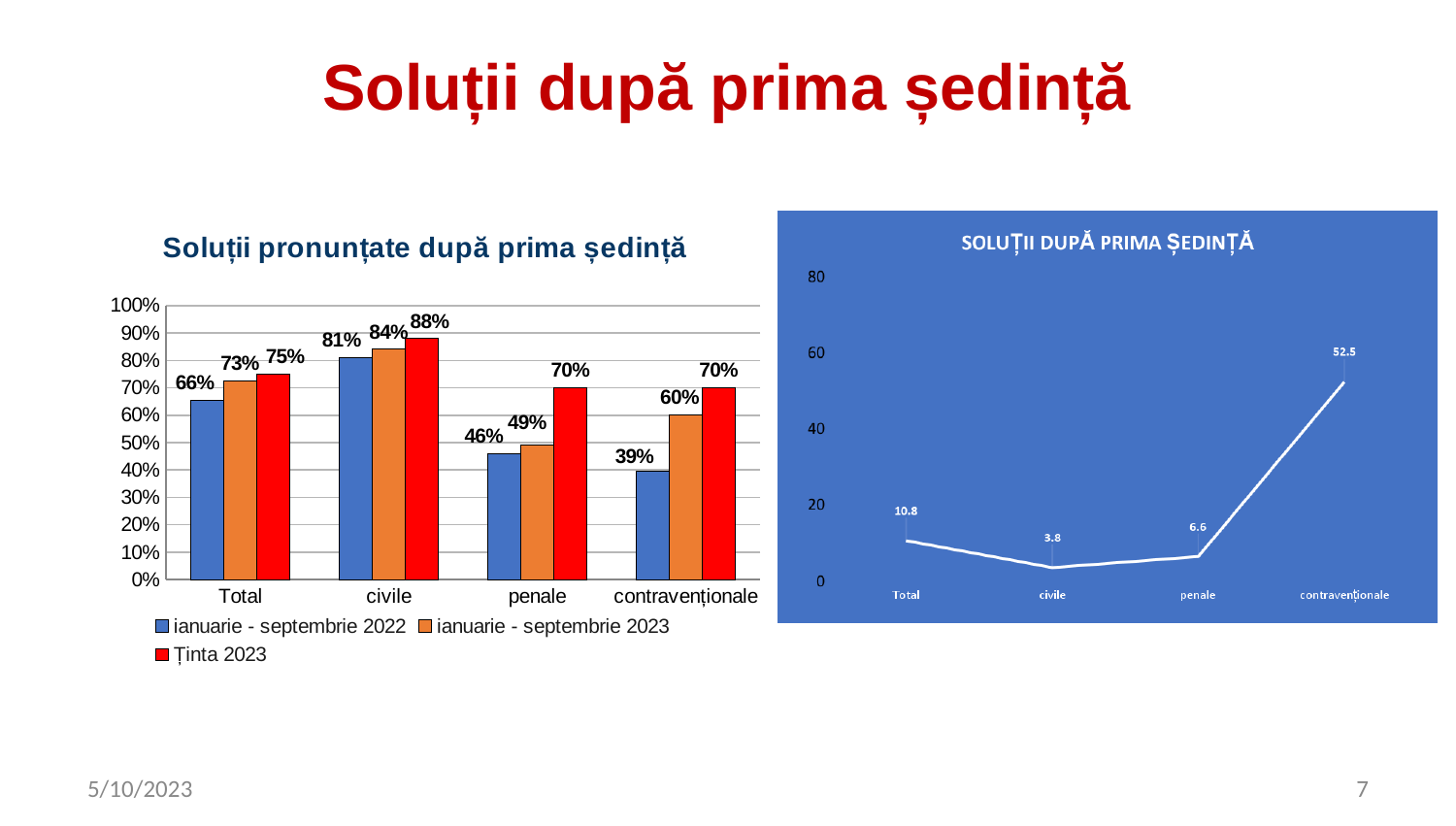
In the left chart 'Soluții pronunțate după prima ședință', which category has the highest value in the 'ianuarie - septembrie 2022' series? civile What kind of chart is the right chart 'SOLUȚII DUPĂ PRIMA ȘEDINȚĂ'? line chart In the right chart 'SOLUȚII DUPĂ PRIMA ȘEDINȚĂ', what is the difference between the values for 'Total' and 'penale'? 4.2 In the left chart 'Soluții pronunțate după prima ședință', what is the difference between the 'Ținta 2023' value and the 'ianuarie - septembrie 2023' value for 'contravenționale'? 10% In the left chart 'Soluții pronunțate după prima ședință', what is the value for 'civile' in the 'ianuarie - septembrie 2023' series? 84% In the left chart 'Soluții pronunțate după prima ședință', how many series does the legend list? 3 In the left chart 'Soluții pronunțate după prima ședință', what is the 'Ținta 2023' value for 'penale'? 70% In the right chart 'SOLUȚII DUPĂ PRIMA ȘEDINȚĂ', which category has the lowest value? civile In the left chart 'Soluții pronunțate după prima ședință', which category has the lowest value in the 'ianuarie - septembrie 2023' series? penale In the left chart 'Soluții pronunțate după prima ședință', which is larger for 'Total': the 'ianuarie - septembrie 2022' value or the 'ianuarie - septembrie 2023' value? ianuarie - septembrie 2023 In the right chart 'SOLUȚII DUPĂ PRIMA ȘEDINȚĂ', what is the value for 'contravenționale'? 52.5 In the left chart 'Soluții pronunțate după prima ședință', what is the value for 'contravenționale' in the 'ianuarie - septembrie 2022' series? 39%